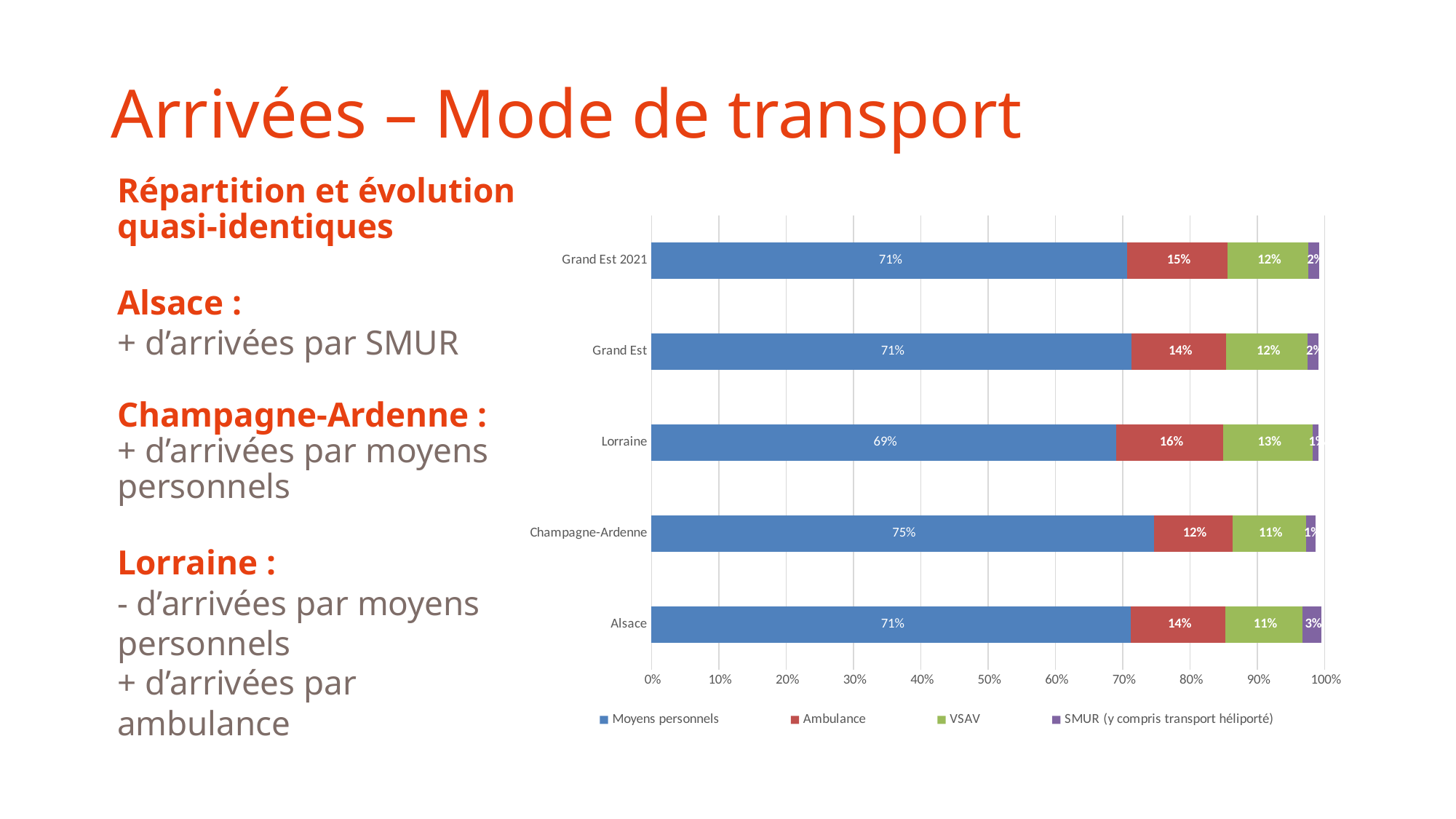
What is the Moyens personnels share for Champagne-Ardenne? 75% Which is larger: the SMUR share for Alsace or for Grand Est? Alsace How many series does the legend list? 4 Which category has the highest Moyens personnels share? Champagne-Ardenne Which category has the lowest Moyens personnels share? Lorraine What is the difference between the Ambulance share for Lorraine and for Champagne-Ardenne? 4% What kind of chart is shown on the slide? Stacked bar chart Which series is shown in blue in the chart? Moyens personnels What is the SMUR (y compris transport héliporté) share for Alsace? 3% What is the VSAV share for Grand Est 2021? 12% What is the Ambulance share for Lorraine? 16% How many categories are shown on the chart? 5